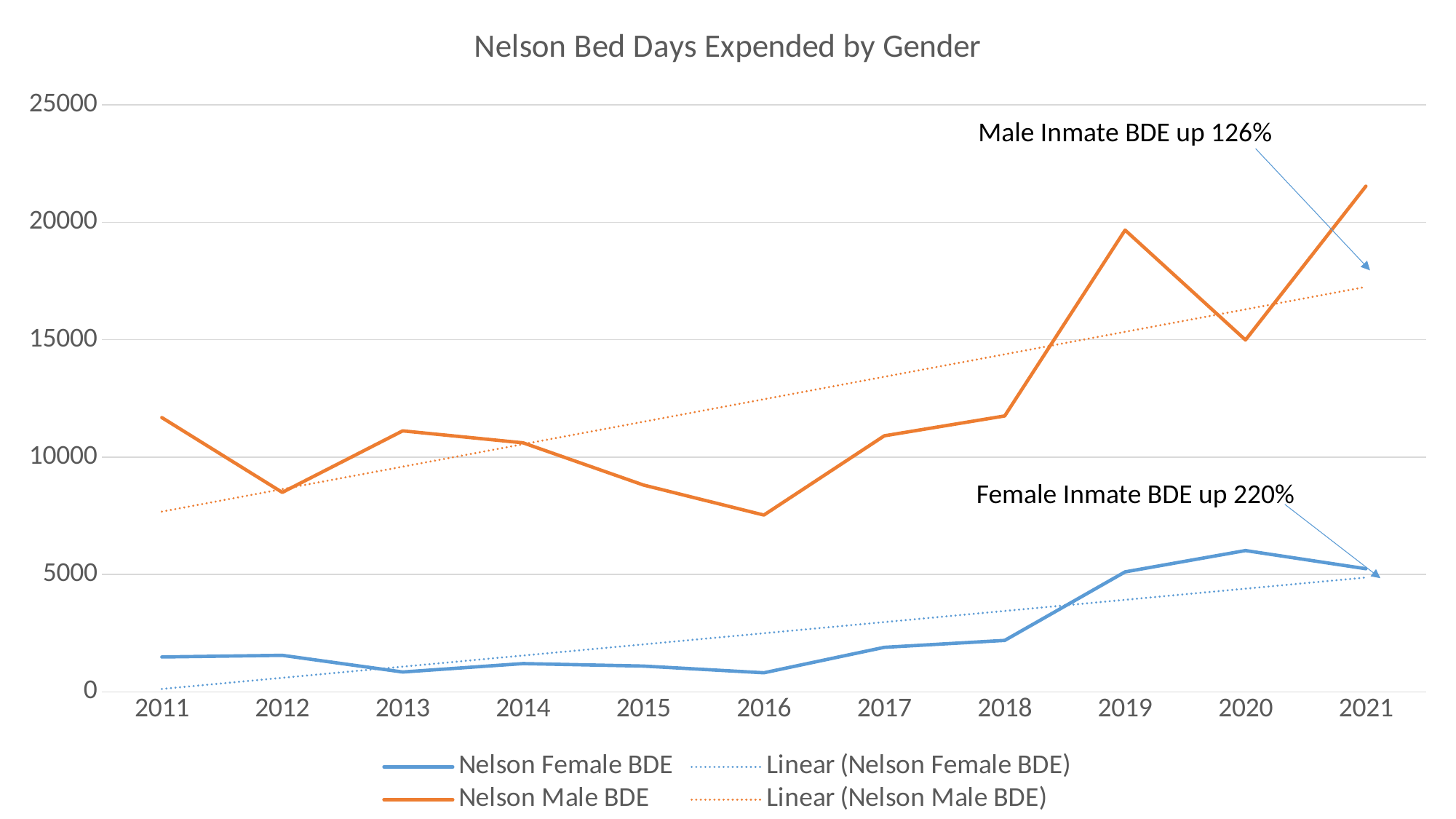
In which year is Nelson Female BDE highest? 2020 In which year is Nelson Male BDE lowest? 2016 How many entries does the legend list? 4 Is the value for Nelson Male BDE in 2016 greater or less than 10000? less Is the value for Nelson Female BDE in 2020 greater or less than 5000? greater Is the value for Nelson Male BDE in 2021 greater or less than 20000? greater What kind of chart is shown on the slide? line chart According to the annotation on the chart, by what percentage is Female Inmate BDE up? 220% In which year is Nelson Male BDE highest? 2021 According to the annotation on the chart, by what percentage is Male Inmate BDE up? 126% Which is larger, Nelson Male BDE in 2011 or in 2012? 2011 How many years are plotted along the x axis? 11